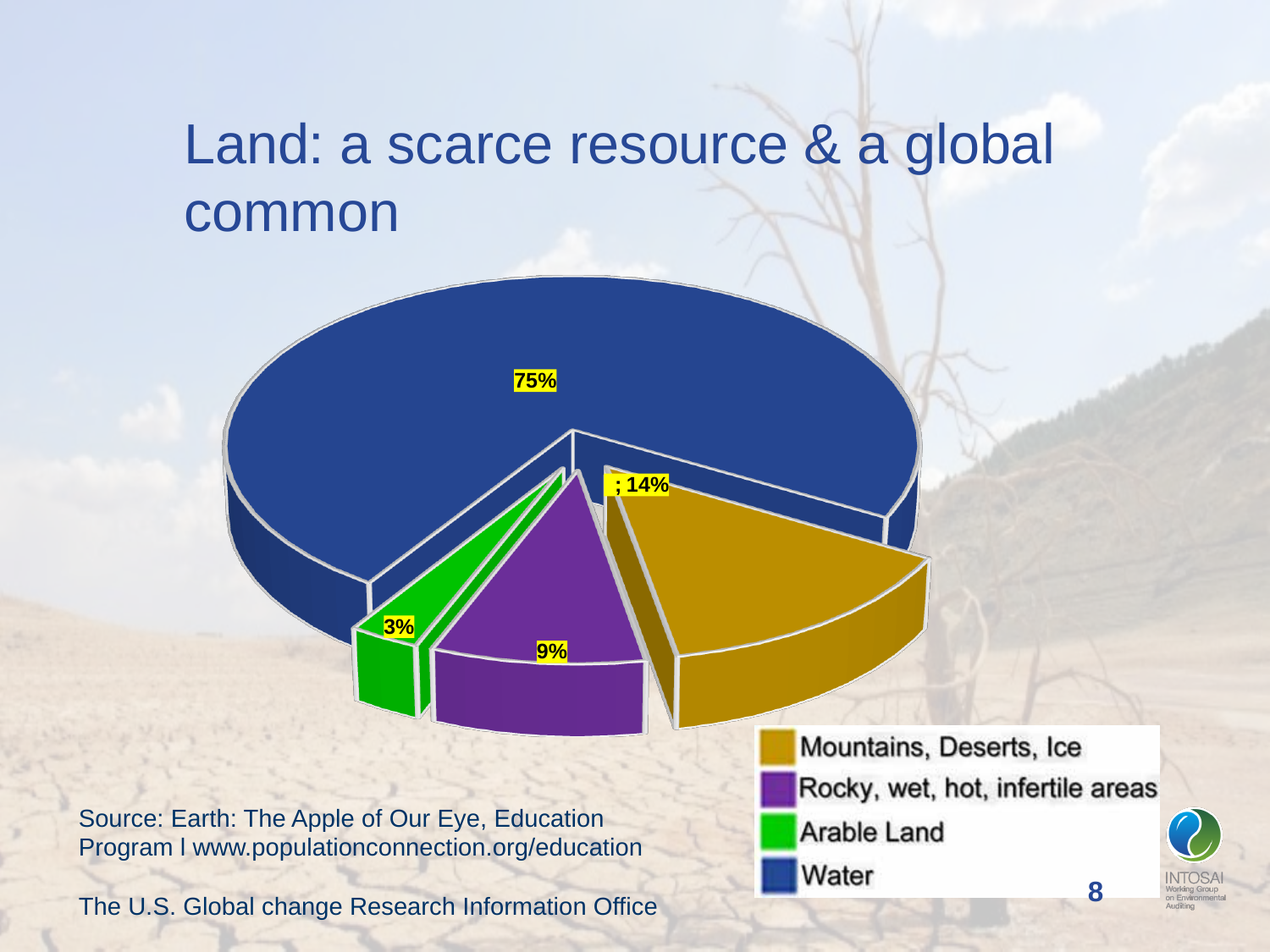
Which category has the largest share of the pie? Water What percentage of the pie is Mountains, Deserts, Ice? 14% What kind of chart is shown on the slide? Pie chart Which is larger, the share for Rocky, wet, hot, infertile areas or the share for Arable Land? Rocky, wet, hot, infertile areas Which category has the smallest share of the pie? Arable Land What percentage of the pie is Water? 75% What is the difference in percentage points between Water and Mountains, Deserts, Ice? 61 What colour is the Arable Land slice? Green What colour is the Water slice? Blue How many categories does the legend list? 4 What percentage of the pie is Arable Land? 3% What percentage of the pie is Rocky, wet, hot, infertile areas? 9%